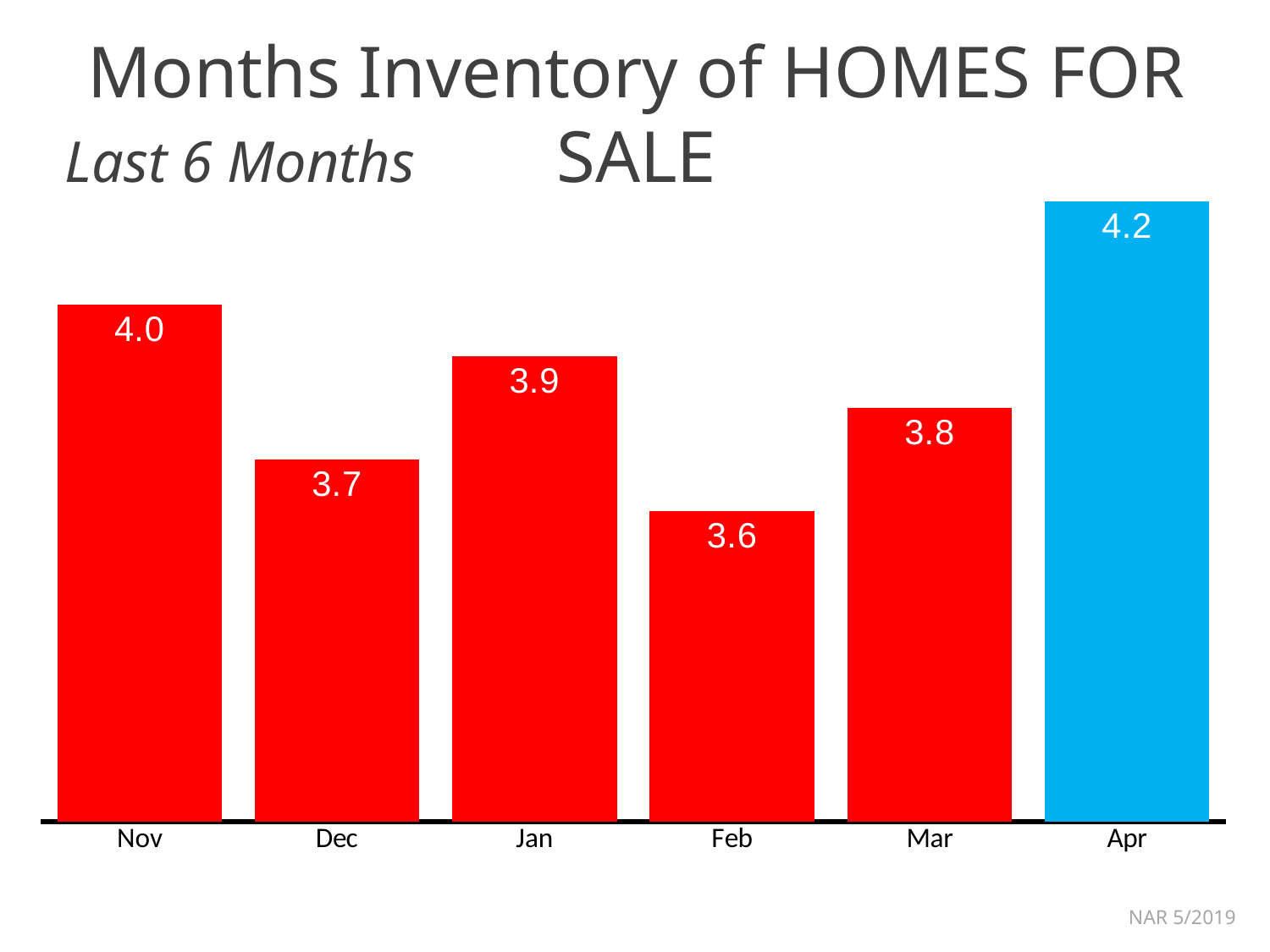
Which month has the lowest months inventory? Feb What is the months inventory value for Apr? 4.2 Which is larger, the value for Jan or the value for Mar? Jan What is the difference between the Nov and Dec values? 0.3 Which bar is coloured differently from the others? Apr Do the values rise or fall from Feb to Apr? Rise What is the months inventory value for Nov? 4.0 What kind of chart is shown on the slide? Bar chart How many months are shown on the chart? 6 What is the months inventory value for Feb? 3.6 Which month has the highest months inventory? Apr What is the difference between the Apr and Feb values? 0.6